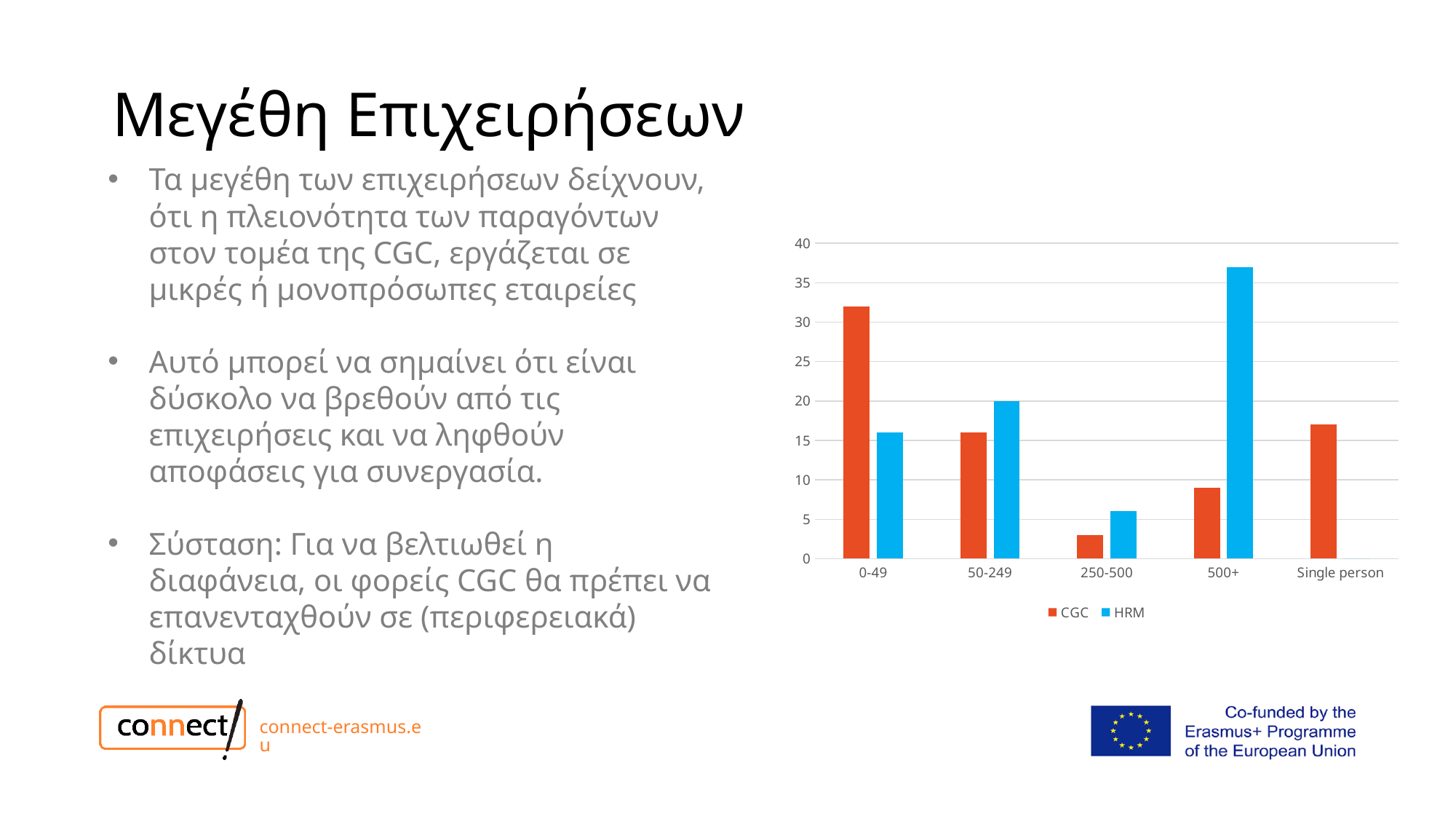
Which category has the highest HRM value? 500+ Is the HRM value for 500+ greater or less than 35? greater How many company-size categories are shown on the x axis? 5 For the 0-49 category, which series has the larger value, CGC or HRM? CGC For the 500+ category, which series has the larger value, CGC or HRM? HRM What kind of chart is shown on the slide? bar chart Is the CGC value for 0-49 greater or less than 30? greater Which category has the lowest CGC value? 250-500 What are the two series named in the legend? CGC and HRM Is the CGC value for 250-500 greater or less than 5? less How many series does the legend list? 2 Which category has the highest CGC value? 0-49